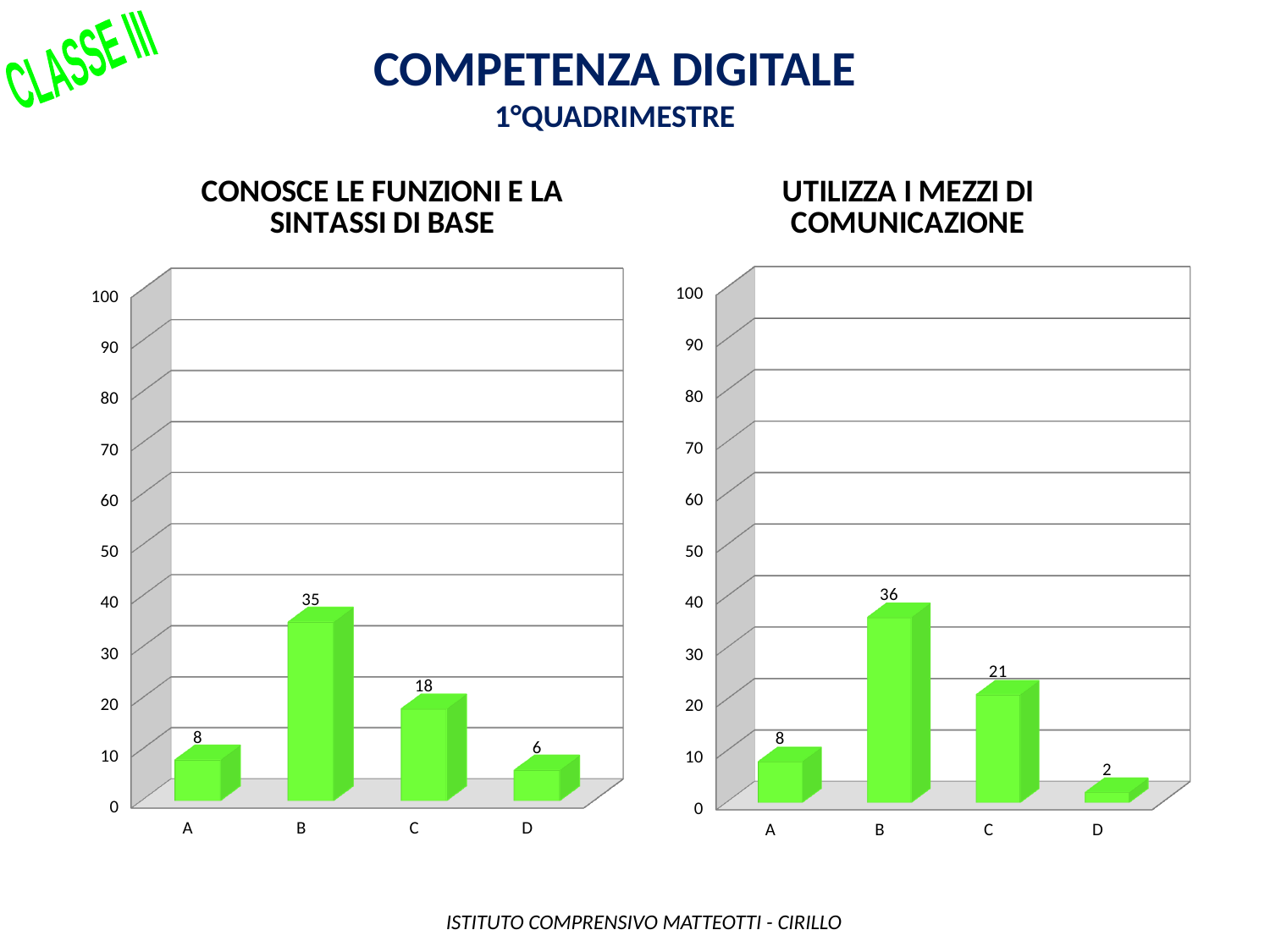
What kind of chart is the chart titled "UTILIZZA I MEZZI DI COMUNICAZIONE"? Bar chart In the chart titled "UTILIZZA I MEZZI DI COMUNICAZIONE", which category has the lowest value? D What is the title of the chart on the left of the slide? CONOSCE LE FUNZIONI E LA SINTASSI DI BASE In the chart titled "UTILIZZA I MEZZI DI COMUNICAZIONE", what is the value for category D? 2 In the chart titled "UTILIZZA I MEZZI DI COMUNICAZIONE", is the value for B greater or less than 30? greater In the chart titled "CONOSCE LE FUNZIONI E LA SINTASSI DI BASE", what is the difference between the values for B and C? 17 In the chart titled "UTILIZZA I MEZZI DI COMUNICAZIONE", what is the difference between the values for A and D? 6 In the chart titled "CONOSCE LE FUNZIONI E LA SINTASSI DI BASE", what is the value for category B? 35 In the chart titled "CONOSCE LE FUNZIONI E LA SINTASSI DI BASE", which is larger, the value for A or the value for D? A How many categories are shown on the x axis of the chart titled "CONOSCE LE FUNZIONI E LA SINTASSI DI BASE"? 4 In the chart titled "CONOSCE LE FUNZIONI E LA SINTASSI DI BASE", which category has the highest value? B In the chart titled "UTILIZZA I MEZZI DI COMUNICAZIONE", what is the value for category C? 21